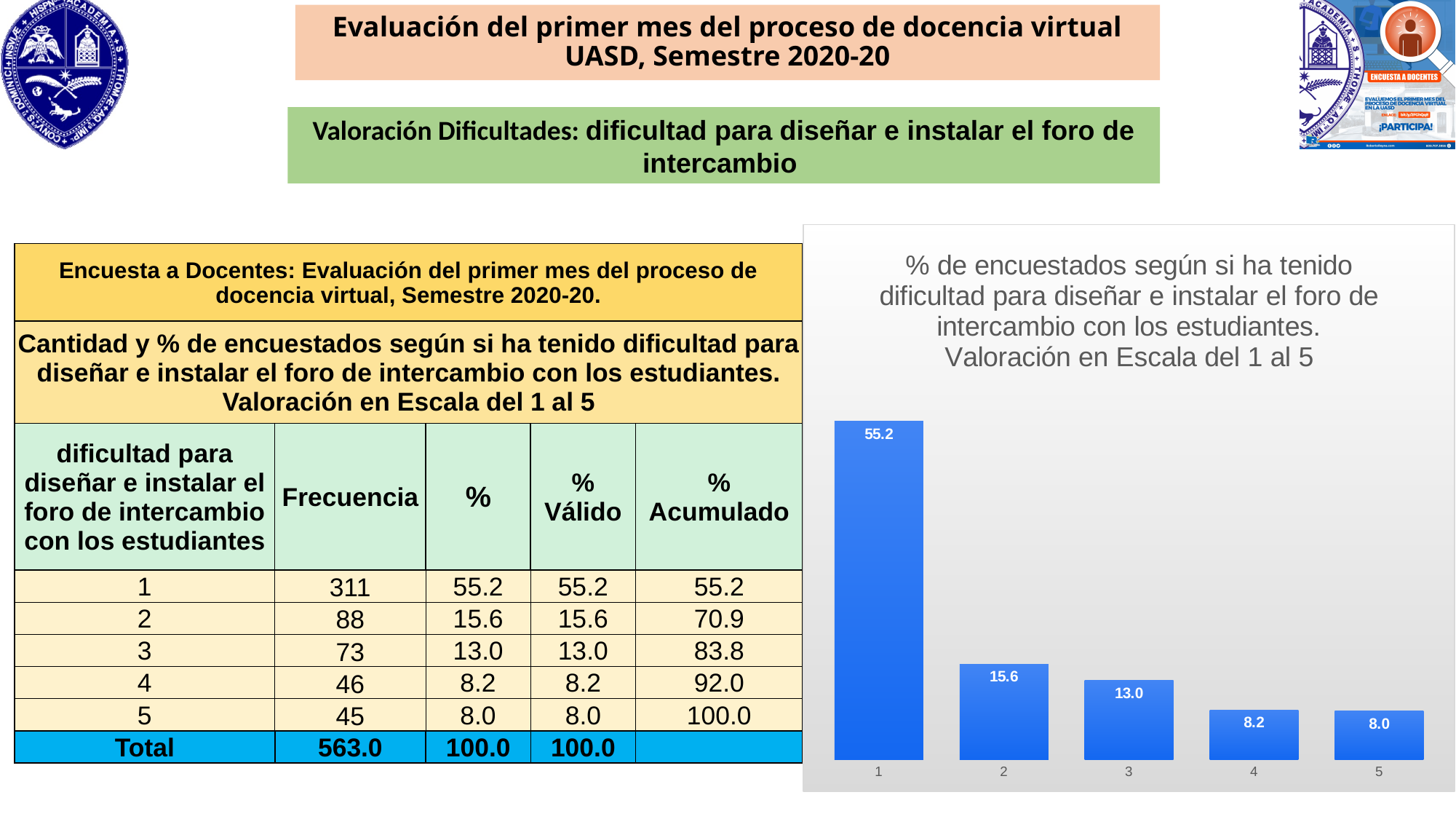
What colour are the bars in the chart? blue Which category has the lowest value in the bar chart? 5 What is the value shown for category 1 in the bar chart? 55.2 Which category has the highest value in the bar chart? 1 Which is larger in the bar chart, the value for category 2 or the value for category 4? 2 What is the value shown for category 3 in the bar chart? 13.0 What kind of chart is shown on the slide? bar chart How many categories are shown on the x axis of the bar chart? 5 What is the value shown for category 5 in the bar chart? 8.0 What is the difference between the values for category 2 and category 3 in the bar chart? 2.6 Do the values in the bar chart rise or fall from category 1 to category 5? fall What is the difference between the values for category 1 and category 2 in the bar chart? 39.6